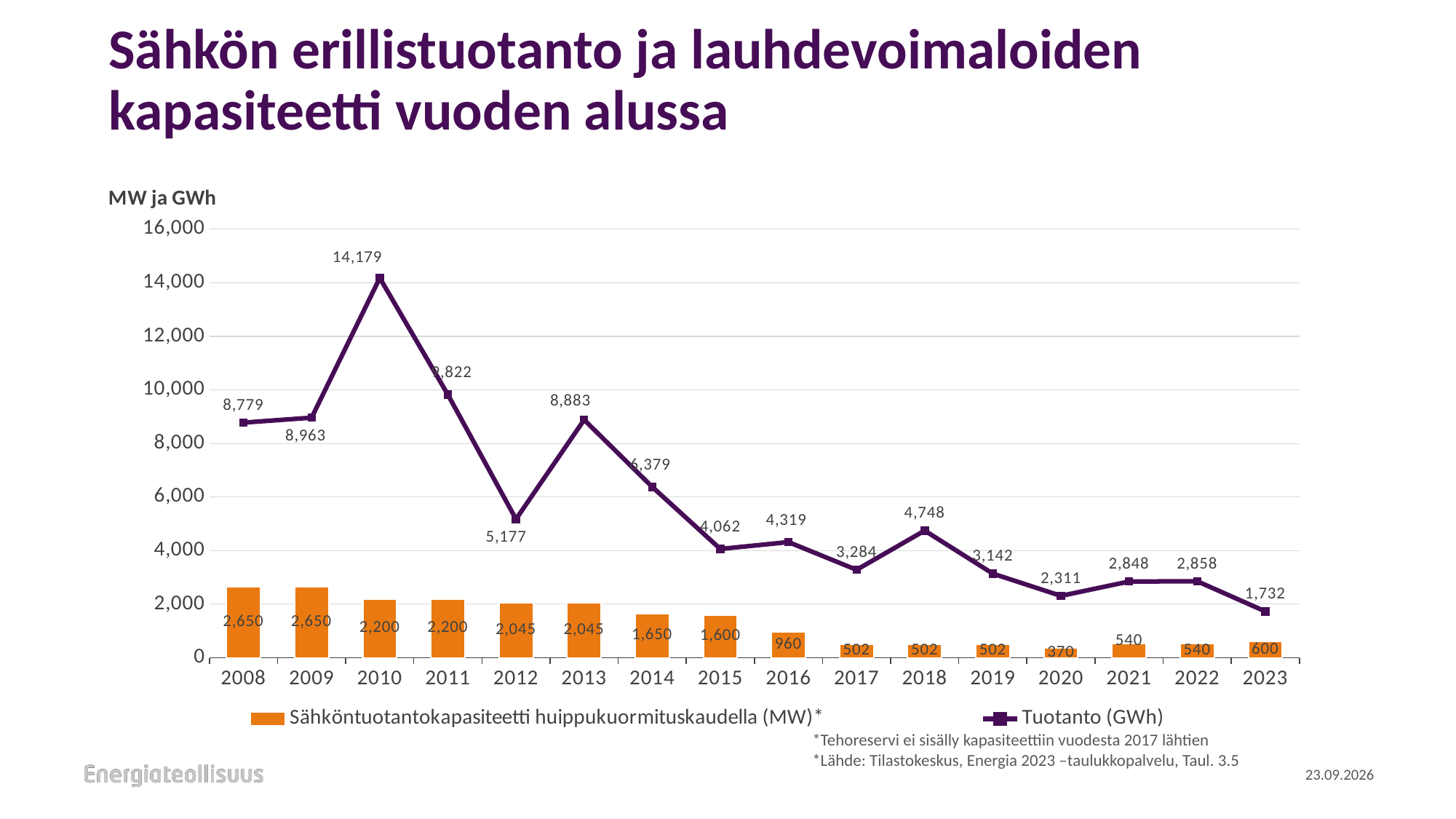
What kind of chart is shown on the slide? Combined bar and line chart Which year has the higher Tuotanto (GWh) value, 2018 or 2019? 2018 How many years are shown on the x axis? 16 How many series does the legend list? 2 What is the difference between the capacity (MW) values for 2008 and 2023? 2,050 In which year is the Sähköntuotantokapasiteetti huippukuormituskaudella (MW) bar lowest? 2020 In which year is Tuotanto (GWh) highest? 2010 What is the Sähköntuotantokapasiteetti huippukuormituskaudella (MW) value for 2016? 960 What is the Tuotanto (GWh) value for 2023? 1,732 What is the difference between the Tuotanto (GWh) values for 2013 and 2012? 3,706 What is the Tuotanto (GWh) value for 2010? 14,179 Does the Sähköntuotantokapasiteetti huippukuormituskaudella (MW) series generally rise or fall from 2008 to 2020? Fall